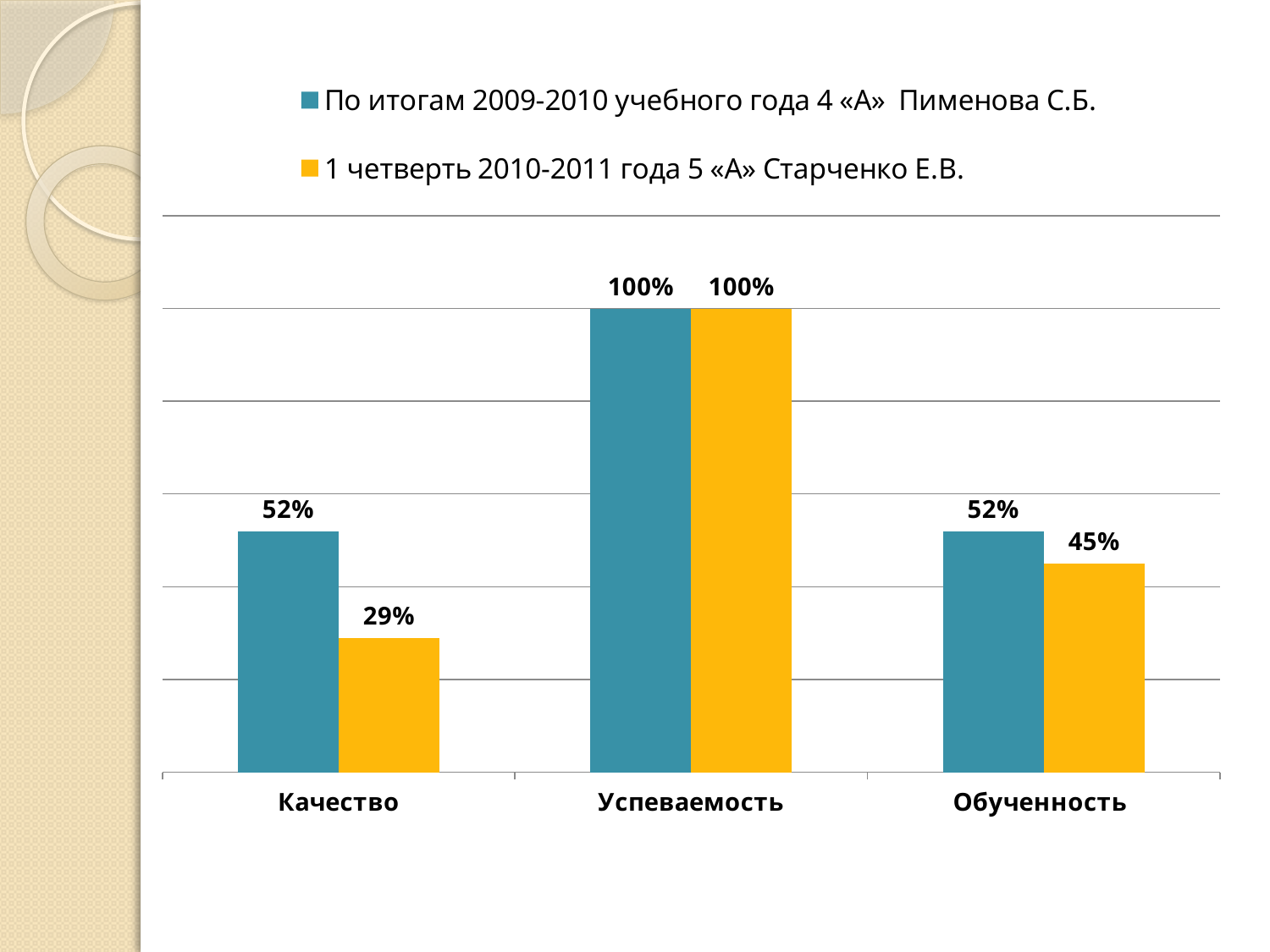
What is the difference between the two series' values for Обученность? 7% What is the value for Качество in the series «1 четверть 2010-2011 года 5 «А» Старченко Е.В.»? 29% How many series does the legend list? 2 What is the value for Качество in the series «По итогам 2009-2010 учебного года 4 «А» Пименова С.Б.»? 52% Which category has the lowest value in the series «1 четверть 2010-2011 года 5 «А» Старченко Е.В.»? Качество What is the difference between the two series' values for Качество? 23% What is the value for Обученность in the series «1 четверть 2010-2011 года 5 «А» Старченко Е.В.»? 45% What is the value for Успеваемость in the series «По итогам 2009-2010 учебного года 4 «А» Пименова С.Б.»? 100% For Обученность, which series has the larger value? По итогам 2009-2010 учебного года 4 «А» Пименова С.Б. Which category has the highest values for both series? Успеваемость What kind of chart is shown on the slide? Bar chart How many categories are shown on the x axis? 3